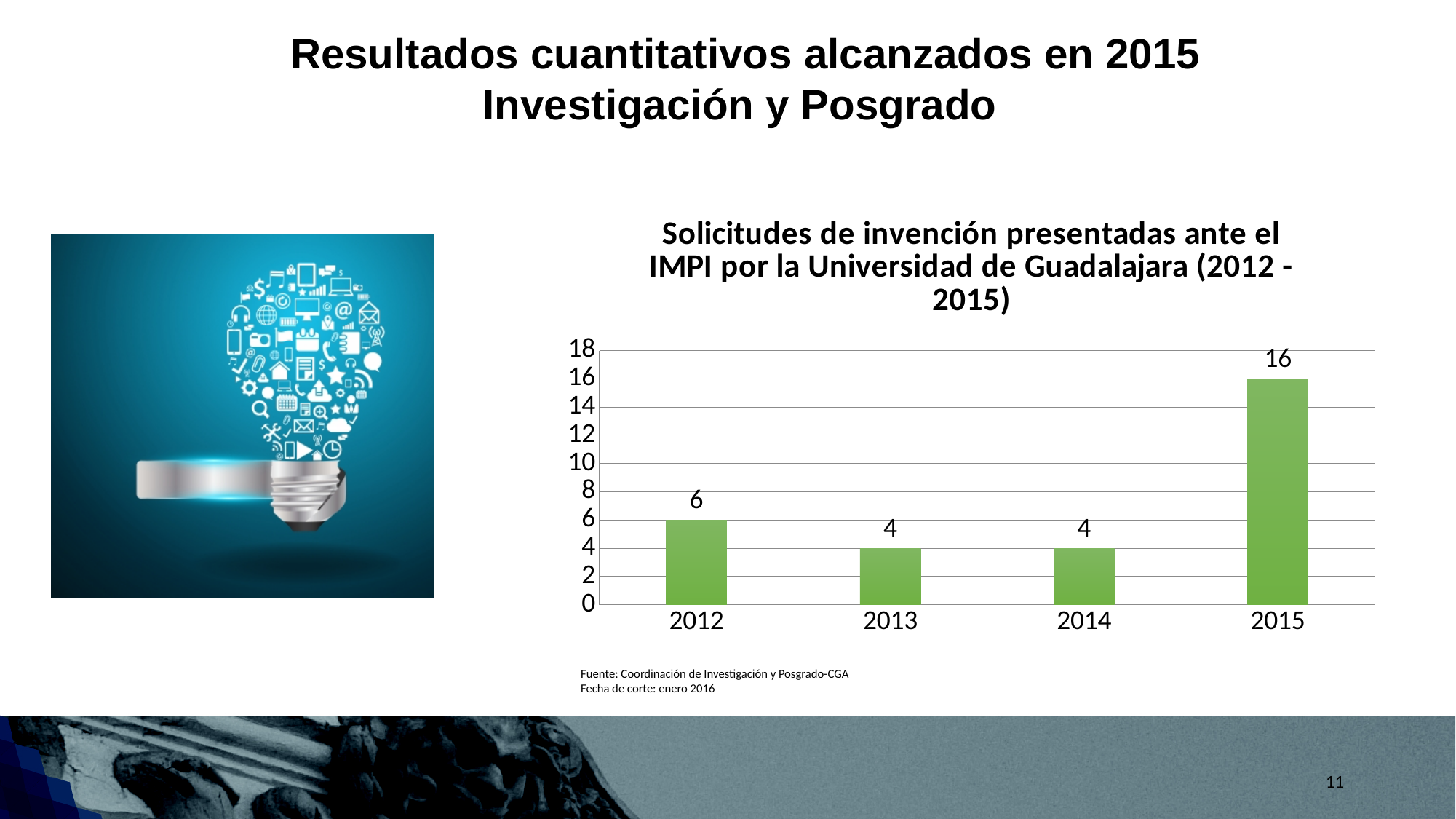
Which is larger, the value for 2012 or the value for 2013? 2012 What is the value for 2012? 6 What is the value for 2013? 4 Is the value for 2015 greater or less than 10? greater What is the difference between the values for 2012 and 2014? 2 What kind of chart is shown on the slide? bar chart How many years are shown on the x axis? 4 Which year has the highest value? 2015 What is the title of the chart? Solicitudes de invención presentadas ante el IMPI por la Universidad de Guadalajara (2012 - 2015) What is the total of the values for 2013 and 2014? 8 What is the difference between the values for 2015 and 2012? 10 What is the value for 2015? 16